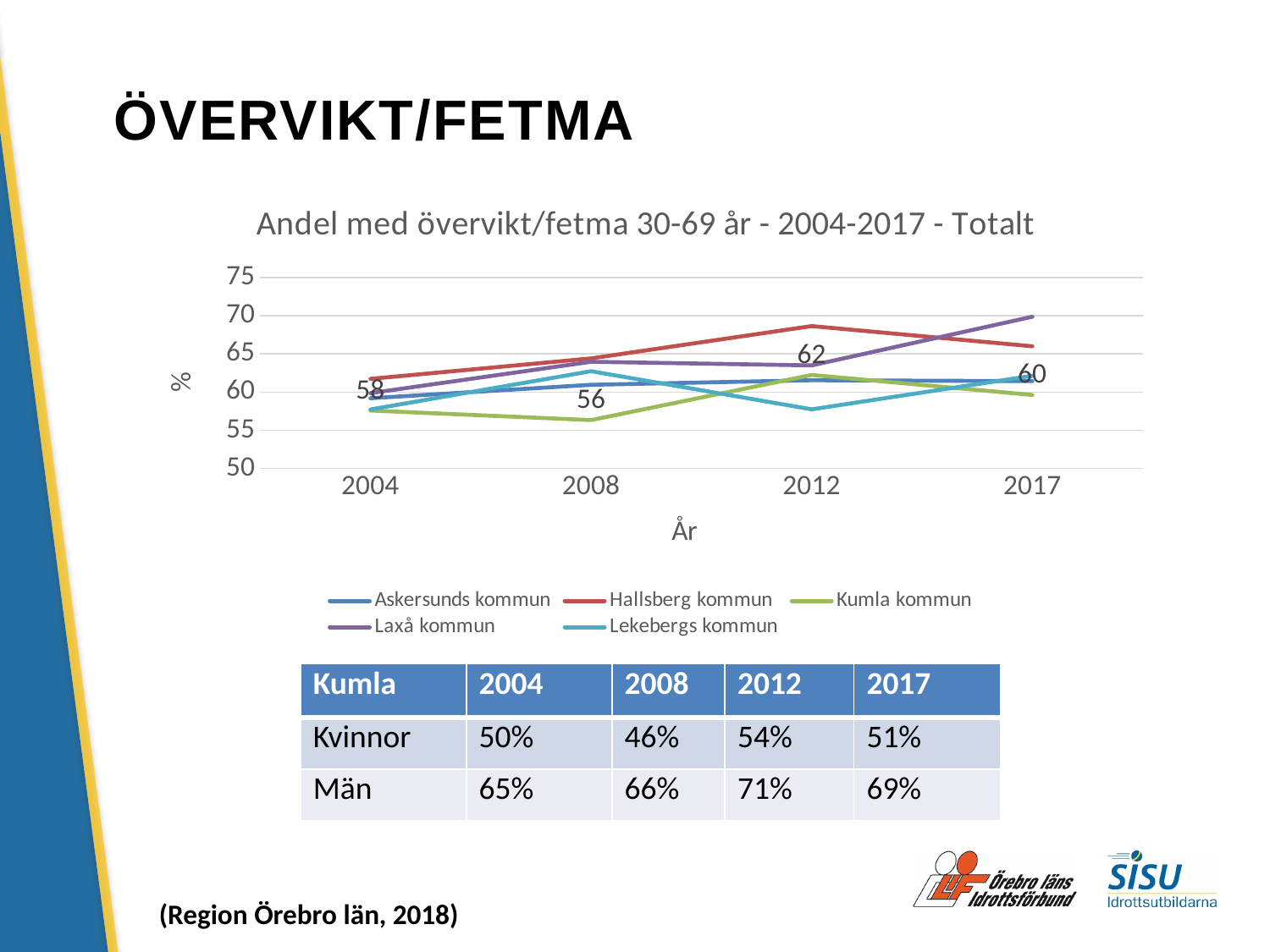
Is the value for Hallsberg kommun in 2012 greater or less than 65? greater What is the value for Kumla kommun in 2008? 56 What is the difference between the Kumla kommun values for 2012 and 2008? 6 What is the title of the chart? Andel med övervikt/fetma 30-69 år - 2004-2017 - Totalt What is the value for Kumla kommun in 2012? 62 Does the line for Laxå kommun rise or fall from 2004 to 2017? rises Which municipality has the lowest value in 2008? Kumla kommun How many years are plotted along the x axis of the chart? 4 Which municipality has the highest value in 2017? Laxå kommun What is the value for Kumla kommun in 2017? 60 How many series does the chart legend list? 5 What kind of chart is shown on the slide? line chart